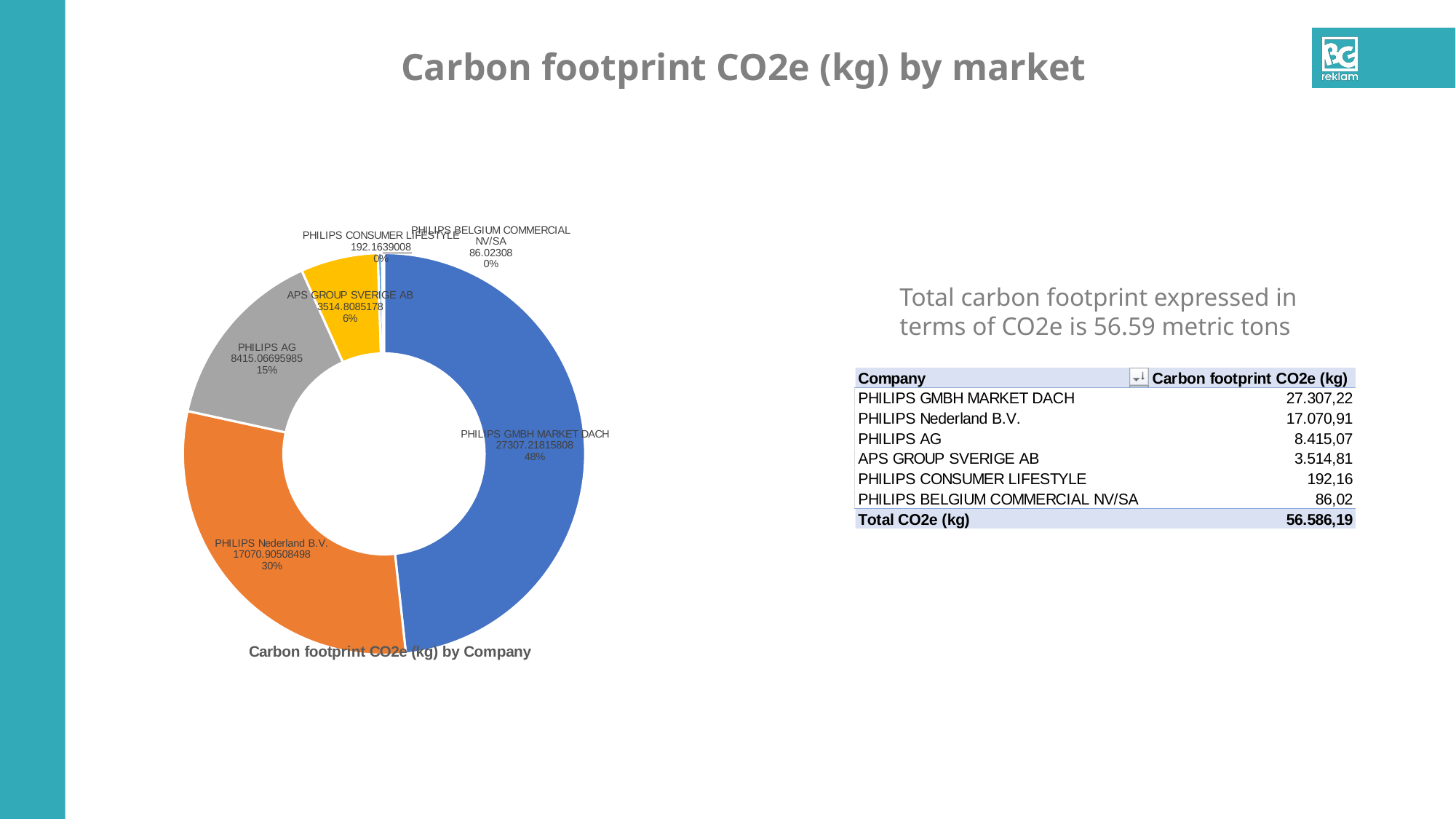
Which company has the largest slice in the chart? PHILIPS GMBH MARKET DACH What share of the total does PHILIPS Nederland B.V. represent in the chart? 30% What type of chart is shown on the slide? Doughnut (pie) chart Which company has the smallest slice in the chart? PHILIPS BELGIUM COMMERCIAL NV/SA What is the carbon footprint value shown for PHILIPS GMBH MARKET DACH in the chart? 27307.21815808 What is the carbon footprint value shown for PHILIPS Nederland B.V. in the chart? 17070.90508498 What share of the total does PHILIPS AG represent in the chart? 15% How many companies (slices) are shown in the chart? 6 What is the title of the chart? Carbon footprint CO2e (kg) by Company What is the carbon footprint value shown for APS GROUP SVERIGE AB in the chart? 3514.8085178 By how many percentage points does the share of PHILIPS GMBH MARKET DACH exceed that of PHILIPS Nederland B.V.? 18 percentage points Which has a larger carbon footprint in the chart, PHILIPS AG or APS GROUP SVERIGE AB? PHILIPS AG